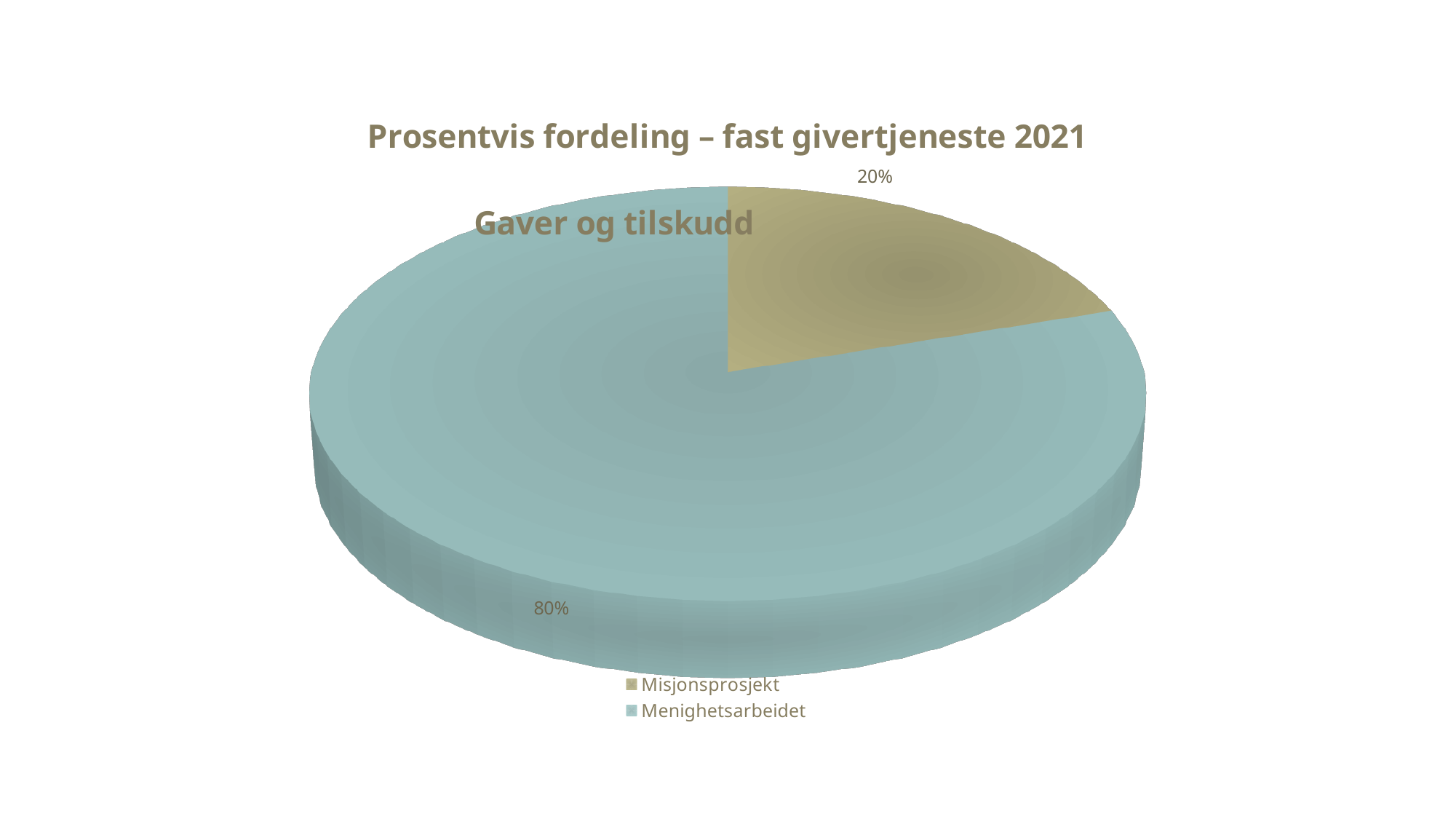
What is the title of the chart? Prosentvis fordeling – fast givertjeneste 2021 How many entries does the legend list? 2 How many categories does the pie chart show? 2 What share of the pie does Menighetsarbeidet represent? 80% Which category has the largest slice of the pie? Menighetsarbeidet Which is larger, the share for Misjonsprosjekt or the share for Menighetsarbeidet? Menighetsarbeidet What kind of chart is shown on the slide? pie chart What is the difference in percentage points between Menighetsarbeidet and Misjonsprosjekt? 60 What share of the pie does Misjonsprosjekt represent? 20% Which category has the smallest slice of the pie? Misjonsprosjekt Which legend entry is shown in the gold/tan colour? Misjonsprosjekt